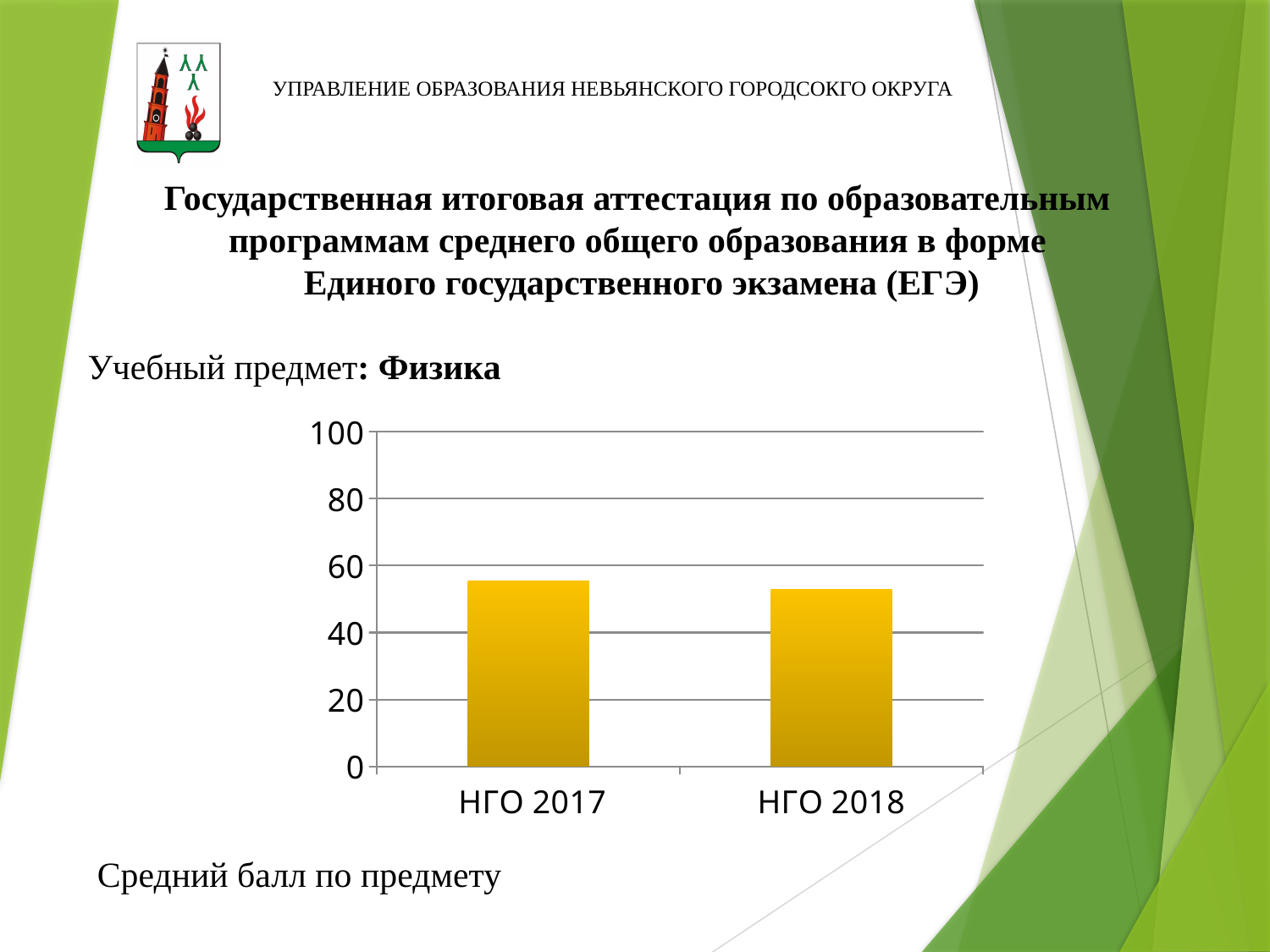
Which category has the higher bar, НГО 2017 or НГО 2018? НГО 2017 Is the value for НГО 2018 greater or less than 40? greater Is the value for НГО 2017 greater or less than 60? less Which school subject does the chart on the slide refer to? Физика Is the value for НГО 2018 greater or less than 60? less How many categories are plotted on the x axis of the chart? 2 What is the highest value shown on the vertical axis of the chart? 100 What kind of chart is shown on the slide? bar chart Do the values rise or fall from НГО 2017 to НГО 2018? fall